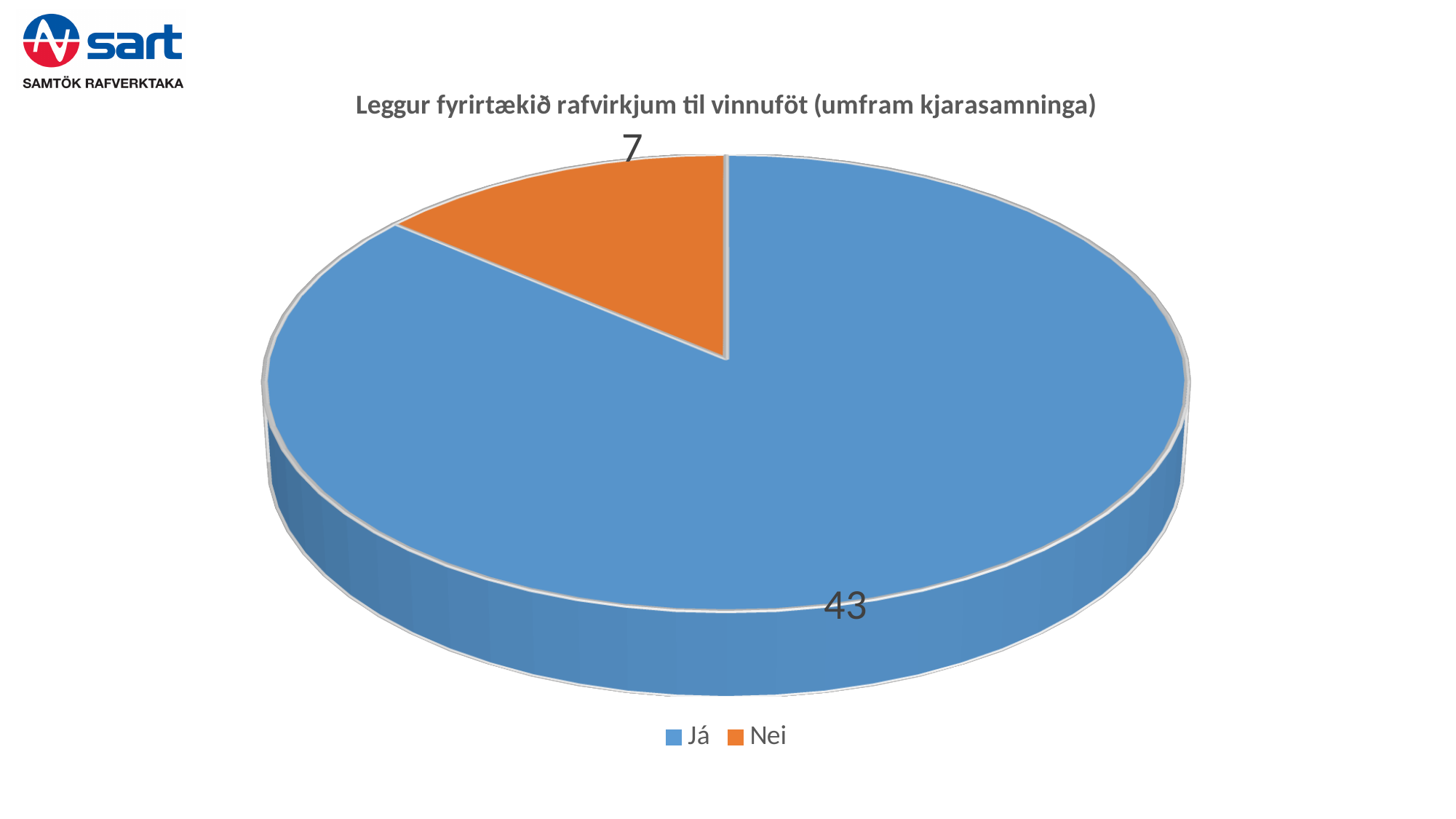
What colour is the Nei slice? Orange What share of the pie does the Nei slice represent? 14% What is the title of the chart? Leggur fyrirtækið rafvirkjum til vinnuföt (umfram kjarasamninga) What kind of chart is shown on the slide? Pie chart What is the value for Já? 43 Which category has the largest slice? Já Which category has the smallest slice? Nei What is the difference between the values for Já and Nei? 36 What is the total of all slices in the pie chart? 50 Which is larger, the value for Já or the value for Nei? Já What is the value for Nei? 7 How many slices does the pie chart have? 2